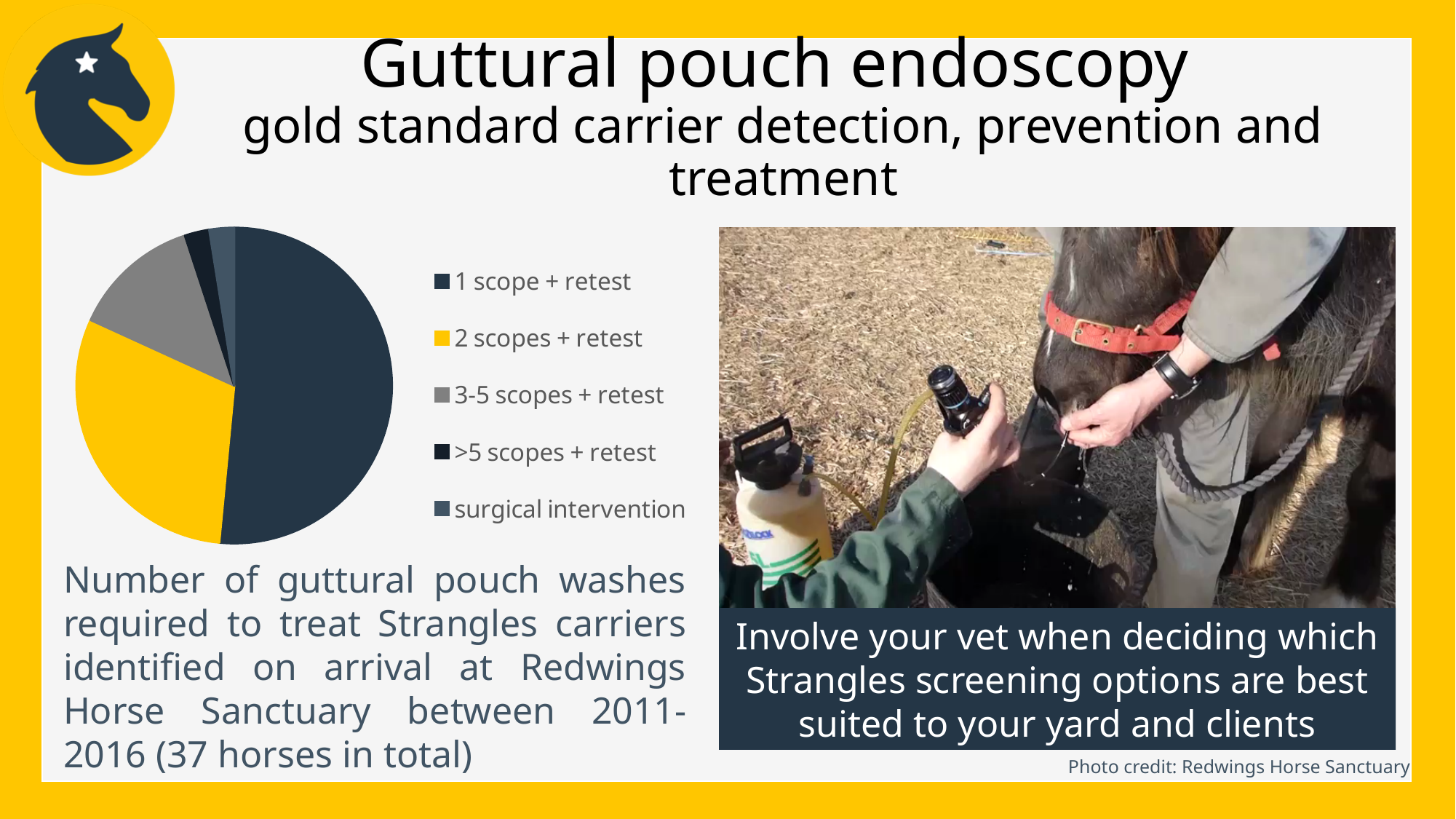
How many slices does the pie chart have? 5 What colour is the 2 scopes + retest slice in the pie chart? yellow How many entries does the pie chart's legend list? 5 What kind of chart is shown on the slide? pie chart Which category takes the largest share of the pie chart? 1 scope + retest Which slice is larger: 3-5 scopes + retest or surgical intervention? 3-5 scopes + retest According to the caption, how many horses in total does the pie chart cover? 37 Which slice is larger: 2 scopes + retest or 3-5 scopes + retest? 2 scopes + retest Which slice is larger: 1 scope + retest or 2 scopes + retest? 1 scope + retest